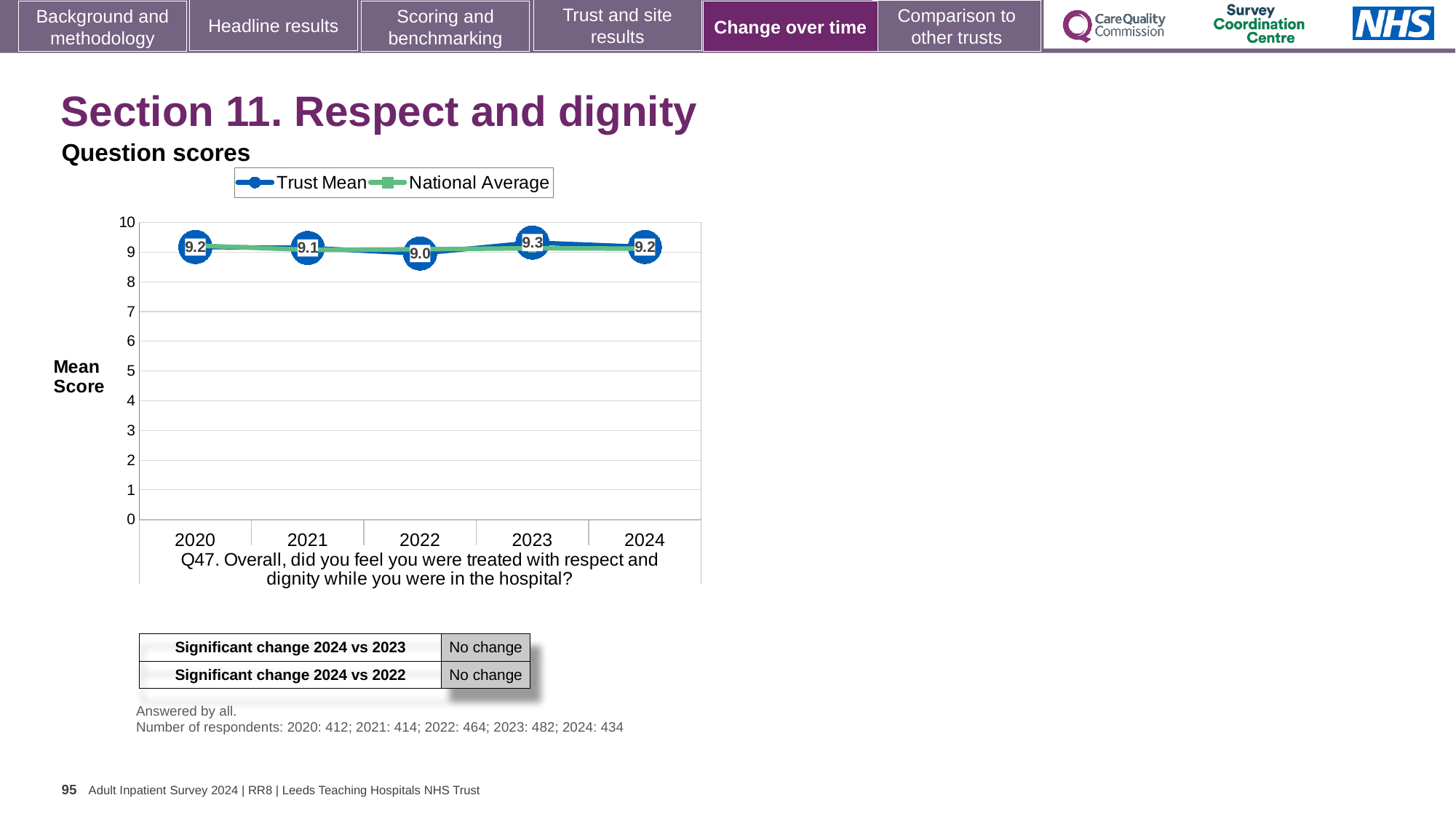
Which is larger, the Trust Mean score for 2021 or for 2023? 2023 How many series does the legend list? 2 What kind of chart is shown on the slide? Line chart What is the Trust Mean score for 2022? 9.0 What is the Trust Mean score for 2020? 9.2 How many years are plotted on the x axis? 5 What is the Trust Mean score for 2023? 9.3 In which year is the Trust Mean score lowest? 2022 What is the Trust Mean score for 2024? 9.2 What is the difference between the Trust Mean scores for 2023 and 2022? 0.3 In which year is the Trust Mean score highest? 2023 Is the Trust Mean score for 2022 greater or less than 8? greater